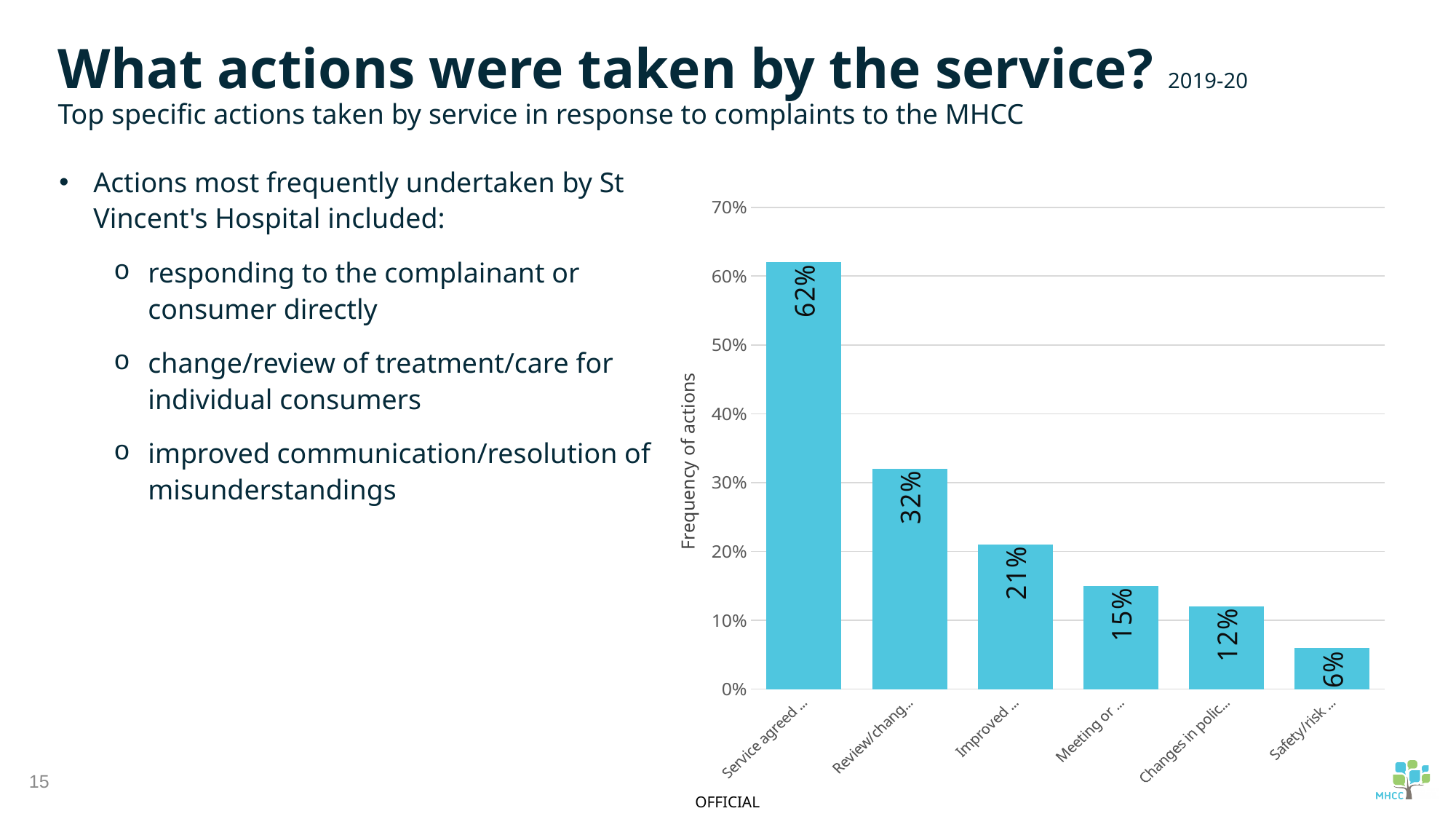
What is the value of the last bar, labelled 'Safety/risk ...'? 6% What type of chart is shown on the slide? bar chart Which bar has the highest value? Service agreed ... Which bar has the lowest value? Safety/risk ... What is the label of the vertical axis? Frequency of actions What is the value of the bar labelled 'Improved ...'? 21% What is the difference between the values of the first bar ('Service agreed ...') and the second bar ('Review/chang...')? 30% How many bars are plotted in the chart? 6 What is the value of the first bar, labelled 'Service agreed ...'? 62% What is the value of the bar labelled 'Meeting or ...'? 15% What is the value of the bar labelled 'Changes in polic...'? 12% What is the value of the bar labelled 'Review/chang...'? 32%